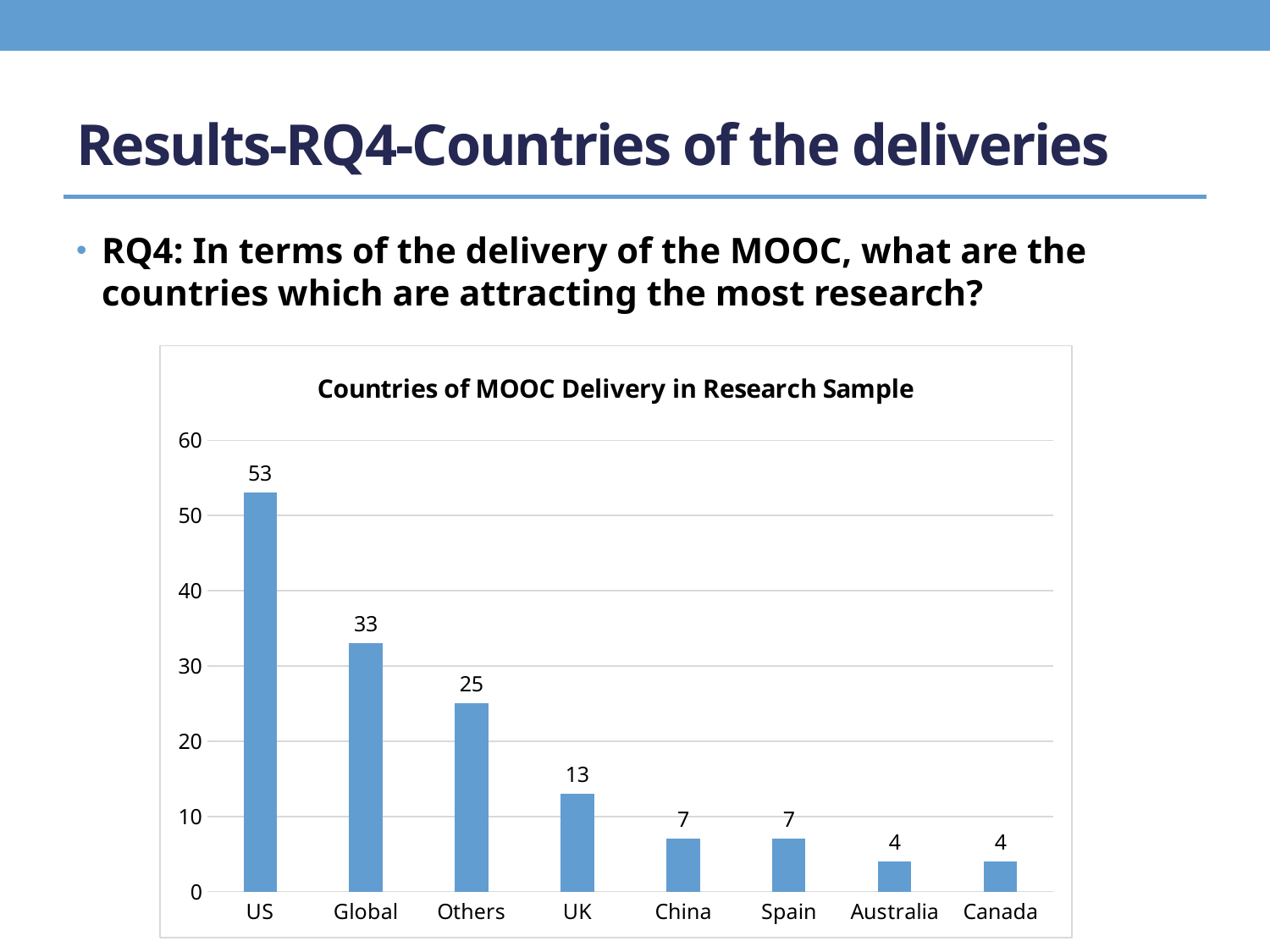
Do the values rise or fall from left to right along the x axis? fall Which category has the highest value? US What is the difference between the values for Others and UK? 12 What is the difference between the values for US and Global? 20 How many categories are shown on the x axis? 8 What is the title of the chart? Countries of MOOC Delivery in Research Sample What is the value for UK? 13 Which is larger, the value for Global or the value for Others? Global What is the value for US? 53 Is the value for Global greater or less than 30? greater What is the value for Others? 25 What kind of chart is shown on the slide? bar chart